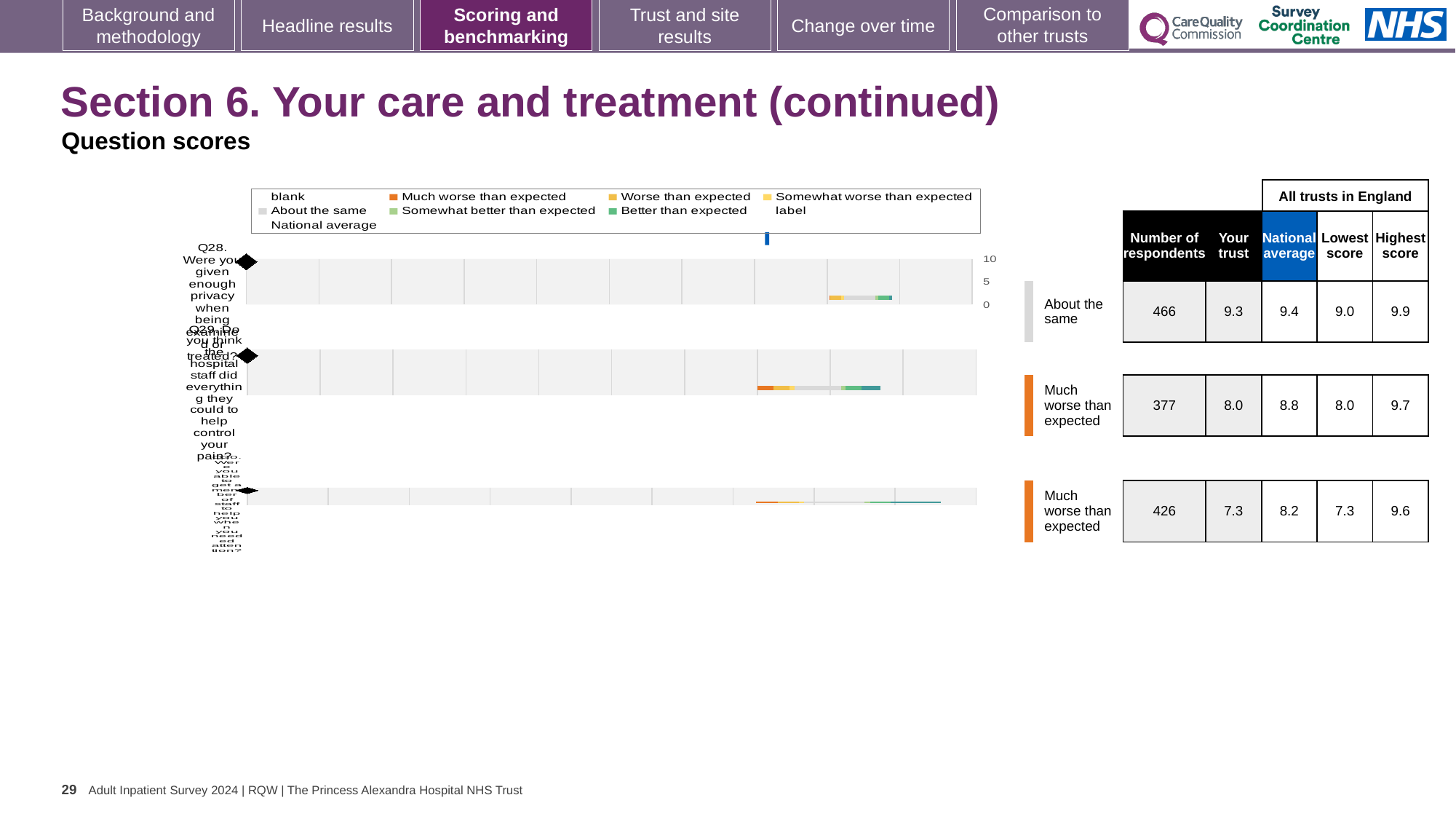
Is the 'Your trust' score for Q29 larger or smaller than the national average for Q29? smaller What is the highest value shown on the chart's axis? 10 Which of the three questions has the lowest 'Your trust' score in the table beside the chart? Q30 According to the table beside the chart, what is the 'Your trust' score for Q28 (privacy when being examined or treated)? 9.3 According to the table beside the chart, what is the national average for Q29 (hospital staff helping control pain)? 8.8 How many entries does the chart legend list? 9 How many questions (rows) are plotted in the chart? 3 What is the difference between the national average and the 'Your trust' score for Q30 in the table beside the chart? 0.9 What kind of chart is shown on the slide? bar chart What benchmark category is shown for Q28 next to the chart? About the same According to the table beside the chart, how many respondents answered Q30 (getting a member of staff to help when needed)? 426 Which of the three questions has the highest 'Your trust' score in the table beside the chart? Q28